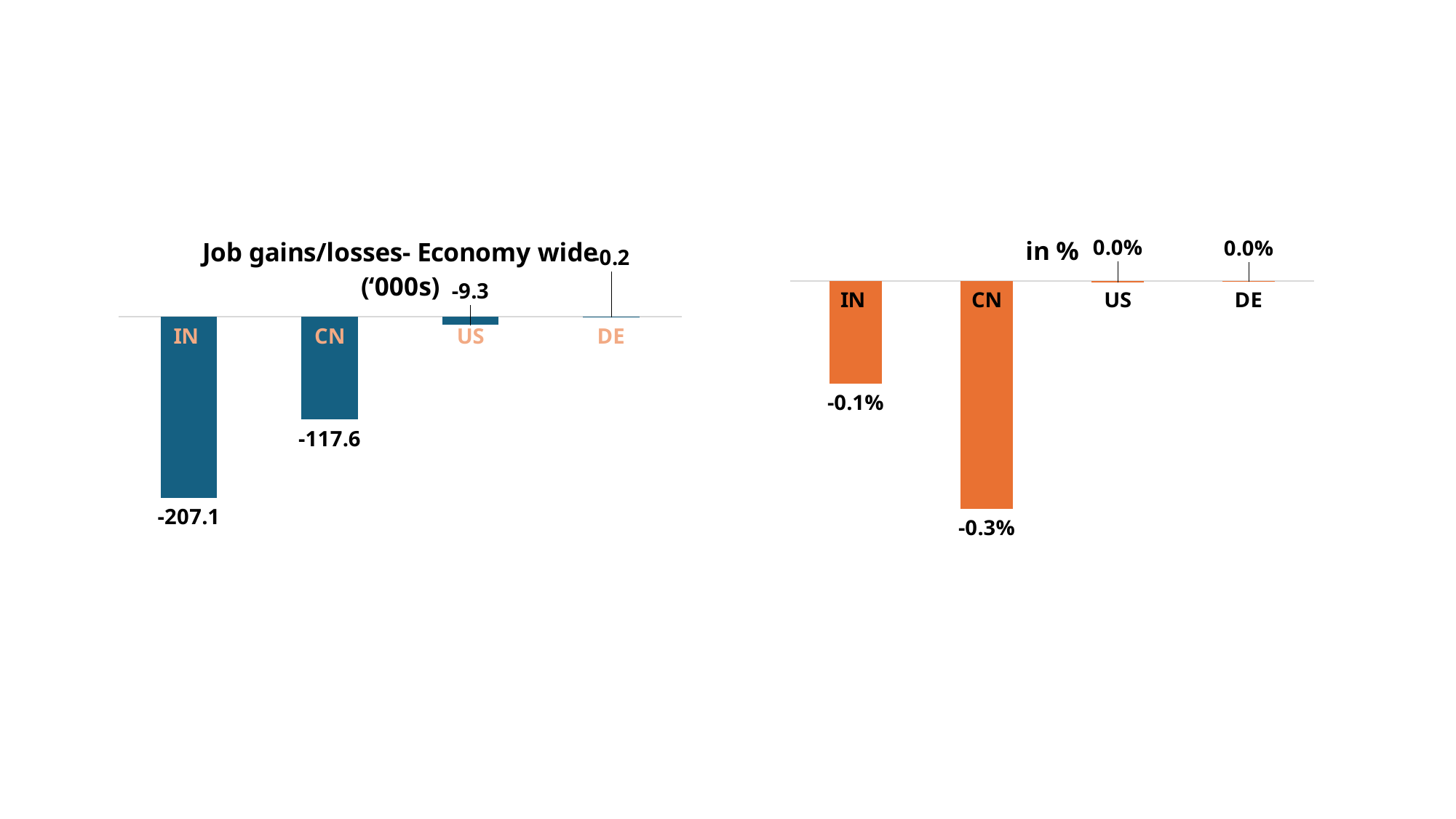
In the 'Job gains/losses- Economy wide ('000s)' chart, what is the difference between the values for CN and IN? 89.5 What kind of chart is the 'in %' chart? bar chart In the 'Job gains/losses- Economy wide ('000s)' chart, what is the value for IN? -207.1 In the 'Job gains/losses- Economy wide ('000s)' chart, what is the value for US? -9.3 In the 'in %' chart, which category has the lowest value? CN In the 'Job gains/losses- Economy wide ('000s)' chart, what is the value for CN? -117.6 In the 'Job gains/losses- Economy wide ('000s)' chart, how many categories are shown? 4 In the 'in %' chart, what is the value for CN? -0.3% In the 'Job gains/losses- Economy wide ('000s)' chart, which category has the highest value? DE In the 'in %' chart, what is the value for IN? -0.1% In the 'Job gains/losses- Economy wide ('000s)' chart, which category has the lowest value? IN